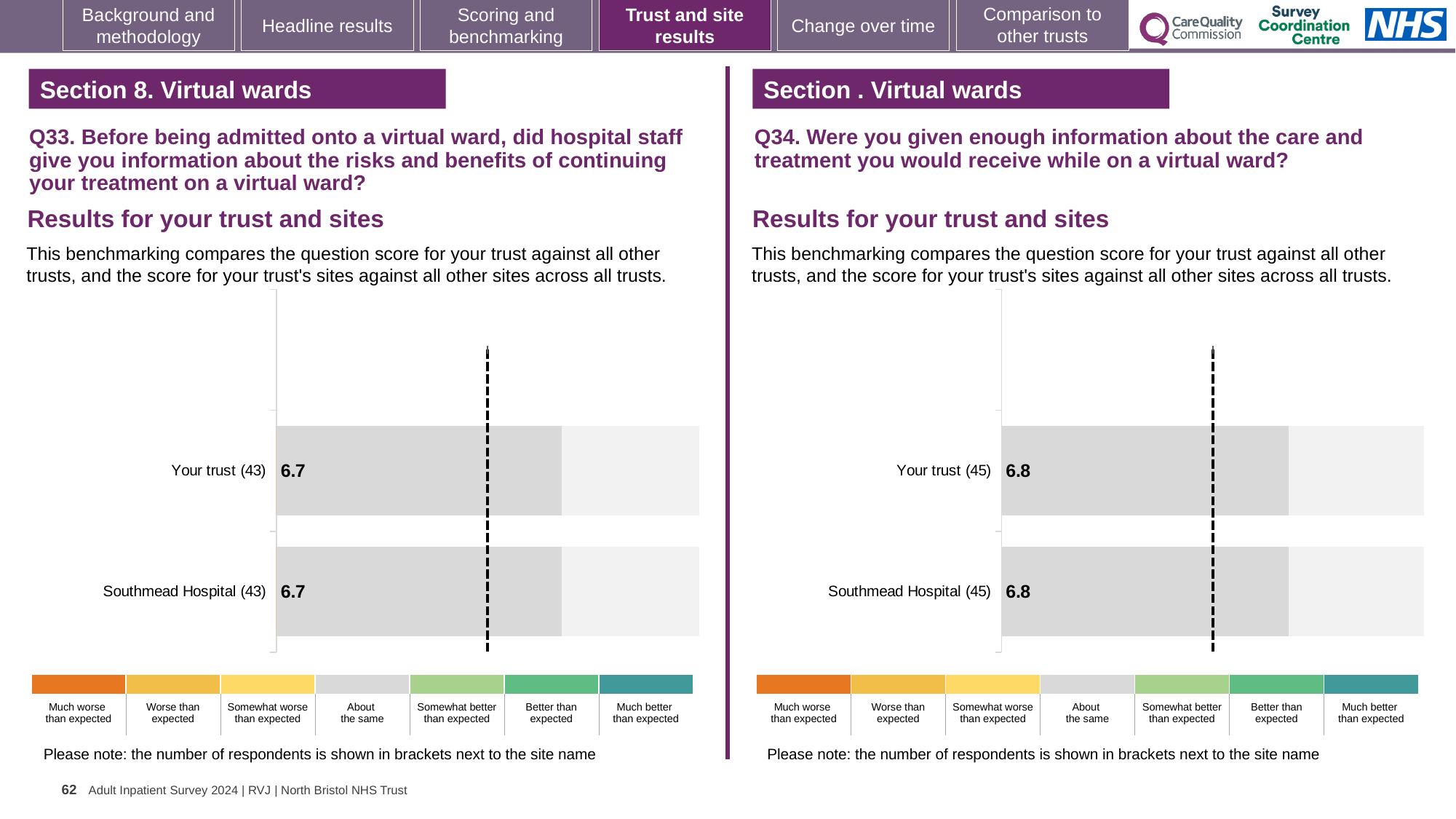
What type of chart is used in the Q34 chart on the right? Bar chart In the Q33 chart on the left, what is the score for Your trust? 6.7 How many bars are plotted in the Q33 chart on the left? 2 In the Q33 chart on the left, what is the score for Southmead Hospital? 6.7 In the Q34 chart on the right, what is the score for Your trust? 6.8 Is the score for Your trust higher in the Q33 chart on the left or the Q34 chart on the right? Q34 chart on the right What is the difference between the Southmead Hospital score in the Q34 chart on the right and the Southmead Hospital score in the Q33 chart on the left? 0.1 How many benchmark bands are shown in the colour key below the Q34 chart on the right? 7 In the Q34 chart on the right, what is the score for Southmead Hospital? 6.8 In the Q33 chart on the left, which benchmark band does the Your trust bar fall into according to the colour key? About the same In the Q33 chart on the left, how many respondents are shown in brackets for Southmead Hospital? 43 In the Q34 chart on the right, how many respondents are shown in brackets for Your trust? 45